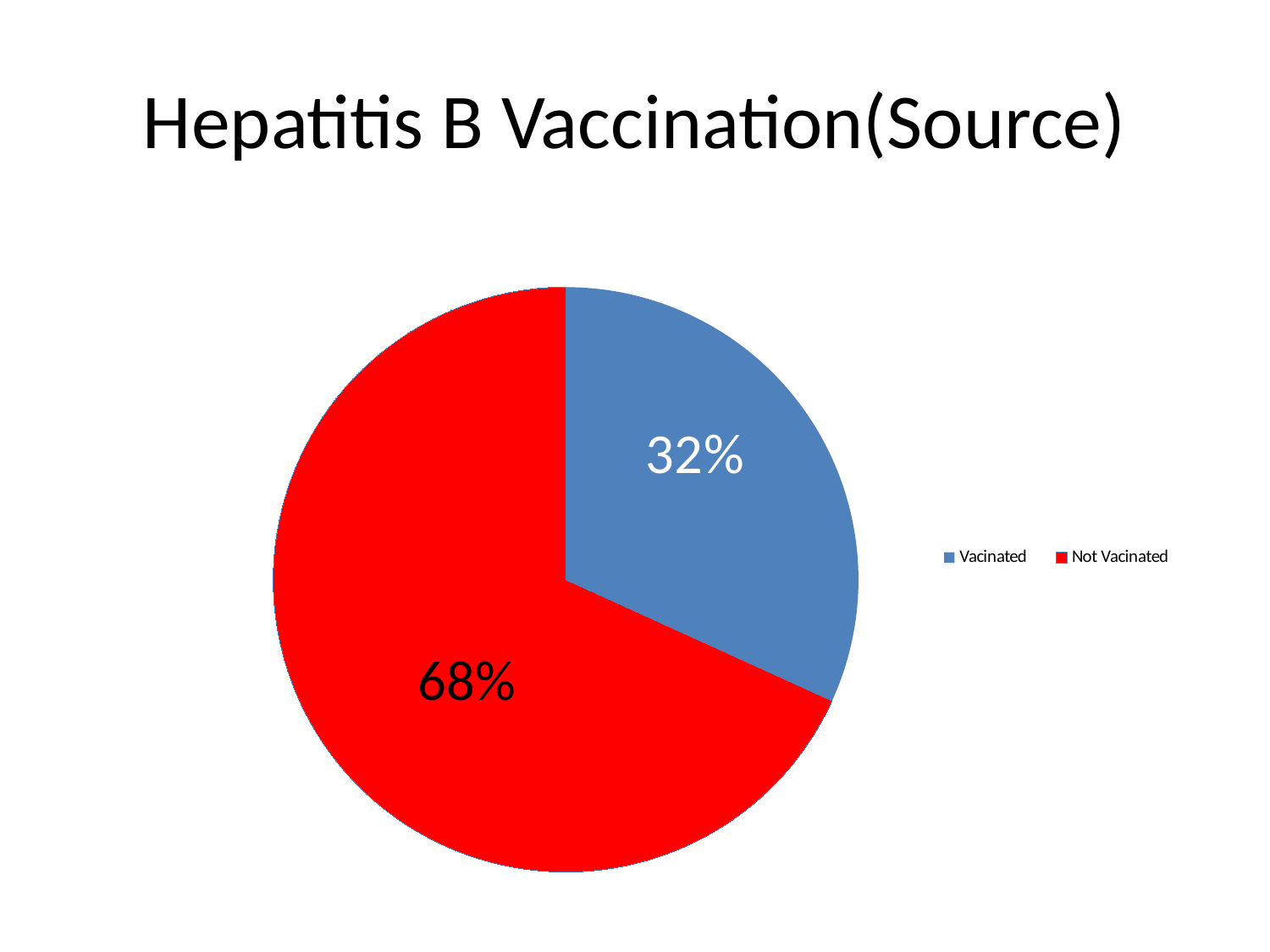
What share of the pie is labelled Not Vacinated? 68% What share of the pie is labelled Vacinated? 32% What is the title of the slide? Hepatitis B Vaccination(Source) Which is larger, the Vacinated slice or the Not Vacinated slice? Not Vacinated How many entries does the legend list? 2 Which slice is the smallest? Vacinated What kind of chart is shown on the slide? pie chart What is the difference in percentage points between the Not Vacinated and Vacinated slices? 36 How many slices does the pie chart have? 2 Which slice is the largest? Not Vacinated What colour is the Not Vacinated slice? red